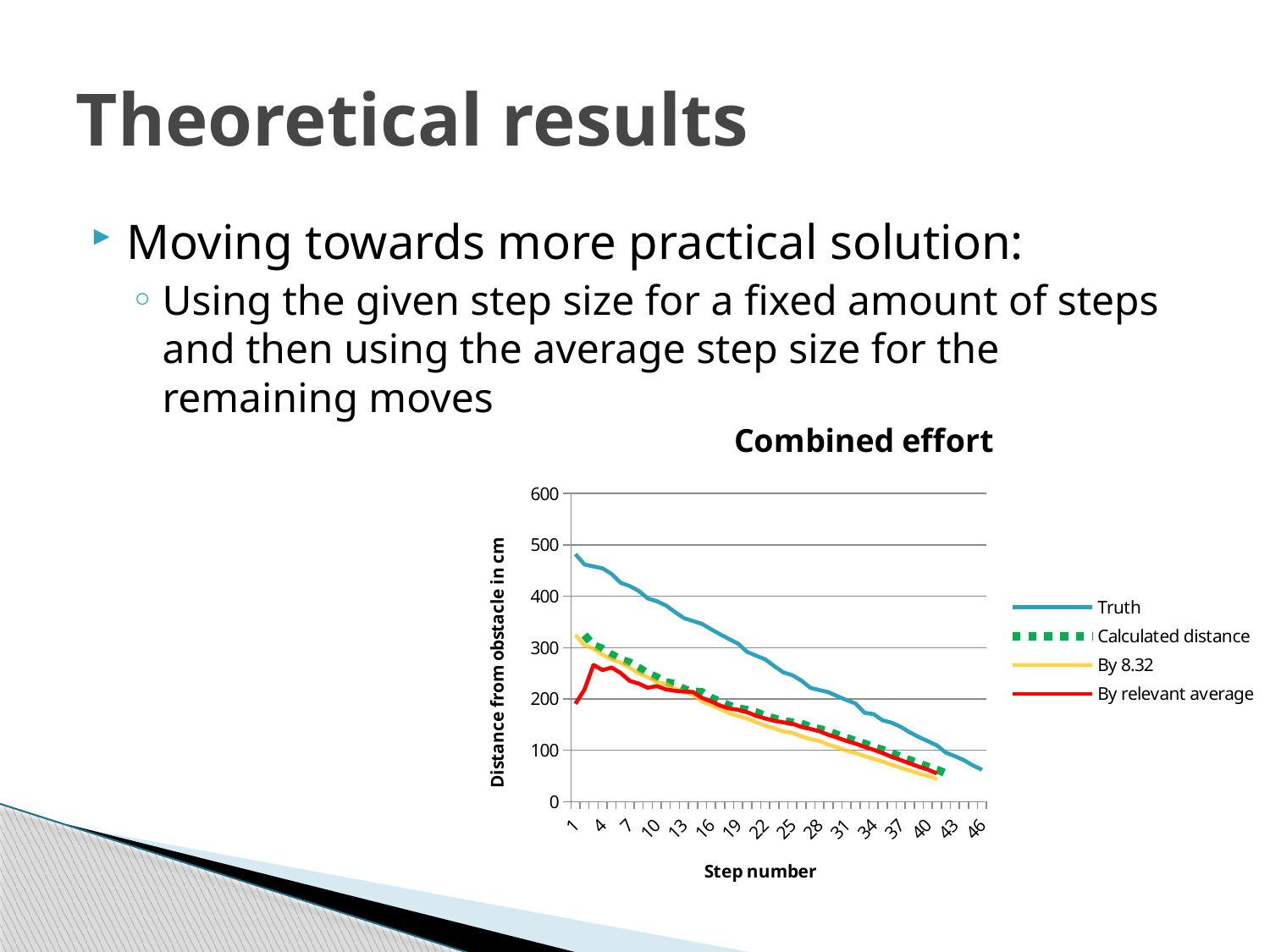
Does the Truth series rise or fall as the step number increases? fall What is the title of the chart? Combined effort How many series does the legend of the chart list? 4 What kind of chart is shown on the slide? line chart Which series in the chart is drawn with a dashed line? Calculated distance Is the value of the Truth series at step 46 greater or less than 100? less Which series has the highest value at step 1? Truth Is the value of the By 8.32 series at step 1 greater or less than 400? less Is the value of the By relevant average series at step 1 greater or less than 300? less At step 1, which is larger: the Truth series or the By relevant average series? Truth Which series has the lowest value at step 1? By relevant average